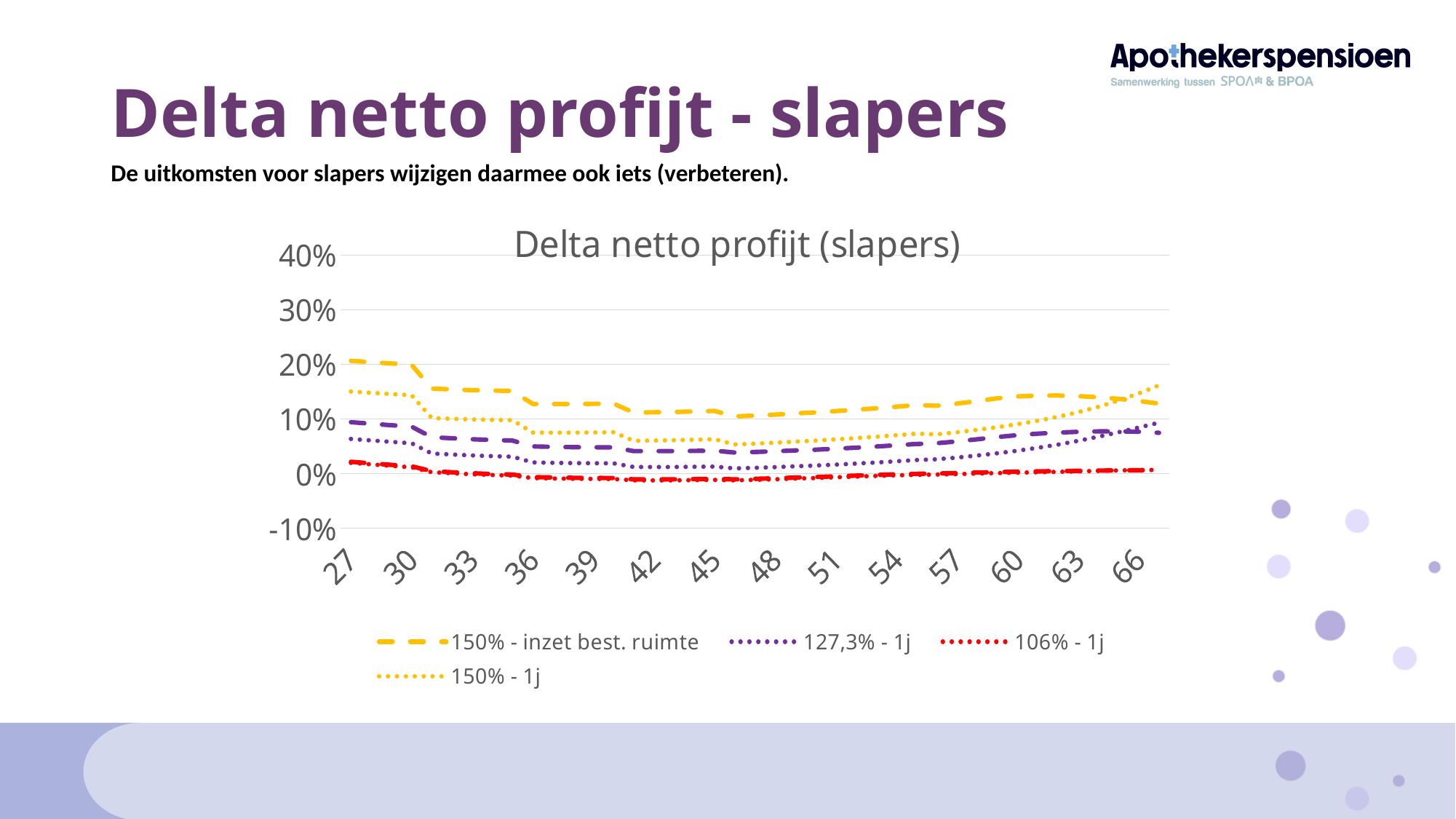
What kind of chart is shown on the slide? line chart At age 27, which is larger: the value for '150% - inzet best. ruimte' or the value for '106% - 1j'? 150% - inzet best. ruimte Is the value for '106% - 1j' at age 27 greater or less than 10%? less Does the '150% - inzet best. ruimte' series rise or fall between age 27 and age 42? fall How many age labels are shown on the x axis? 14 Is the value for '127,3% - 1j' at age 27 greater or less than 20%? less What is the title of the chart? Delta netto profijt (slapers) How many series does the legend list? 4 Which series has the lowest value at age 27? 106% - 1j Which series has the highest value at age 27? 150% - inzet best. ruimte Is the value for '150% - inzet best. ruimte' at age 27 greater or less than 10%? greater